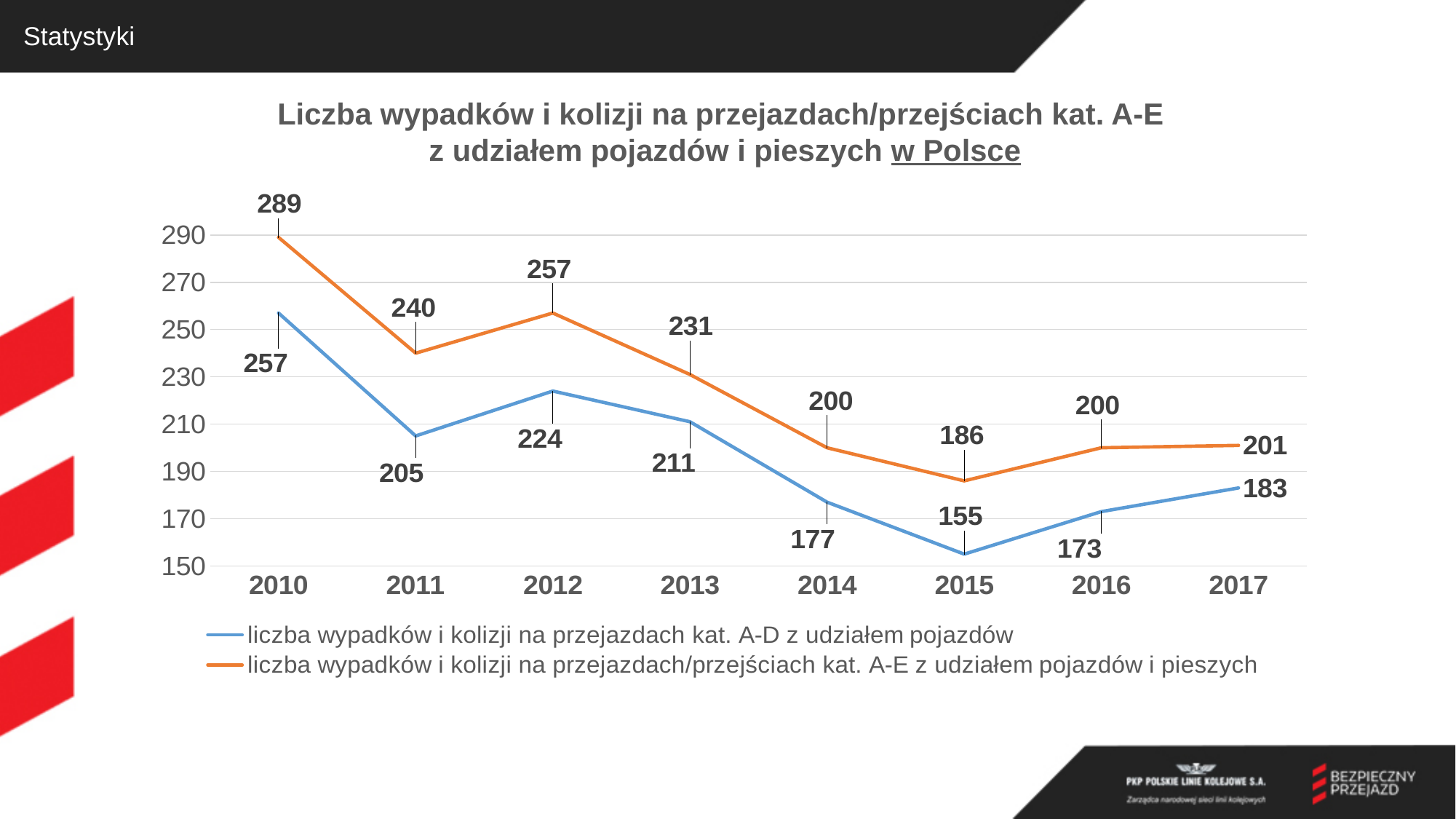
What is the value for 2010 in the series 'liczba wypadków i kolizji na przejazdach/przejściach kat. A-E z udziałem pojazdów i pieszych'? 289 How many years are plotted along the x axis? 8 In which year is the series 'liczba wypadków i kolizji na przejazdach kat. A-D z udziałem pojazdów' at its lowest? 2015 What is the value for 2017 in the series 'liczba wypadków i kolizji na przejazdach/przejściach kat. A-E z udziałem pojazdów i pieszych'? 201 What is the value for 2015 in the series 'liczba wypadków i kolizji na przejazdach kat. A-D z udziałem pojazdów'? 155 What colour is the line for the series 'liczba wypadków i kolizji na przejazdach kat. A-D z udziałem pojazdów'? blue What type of chart is shown on the slide? line chart What is the difference between the two series' values in 2012? 33 How many series does the legend list? 2 In which year is the series 'liczba wypadków i kolizji na przejazdach/przejściach kat. A-E z udziałem pojazdów i pieszych' at its highest? 2010 Which is larger: the value for 2011 or the value for 2013 in the series 'liczba wypadków i kolizji na przejazdach kat. A-D z udziałem pojazdów'? 2013 Does the series 'liczba wypadków i kolizji na przejazdach/przejściach kat. A-E z udziałem pojazdów i pieszych' generally rise or fall from 2010 to 2015? fall